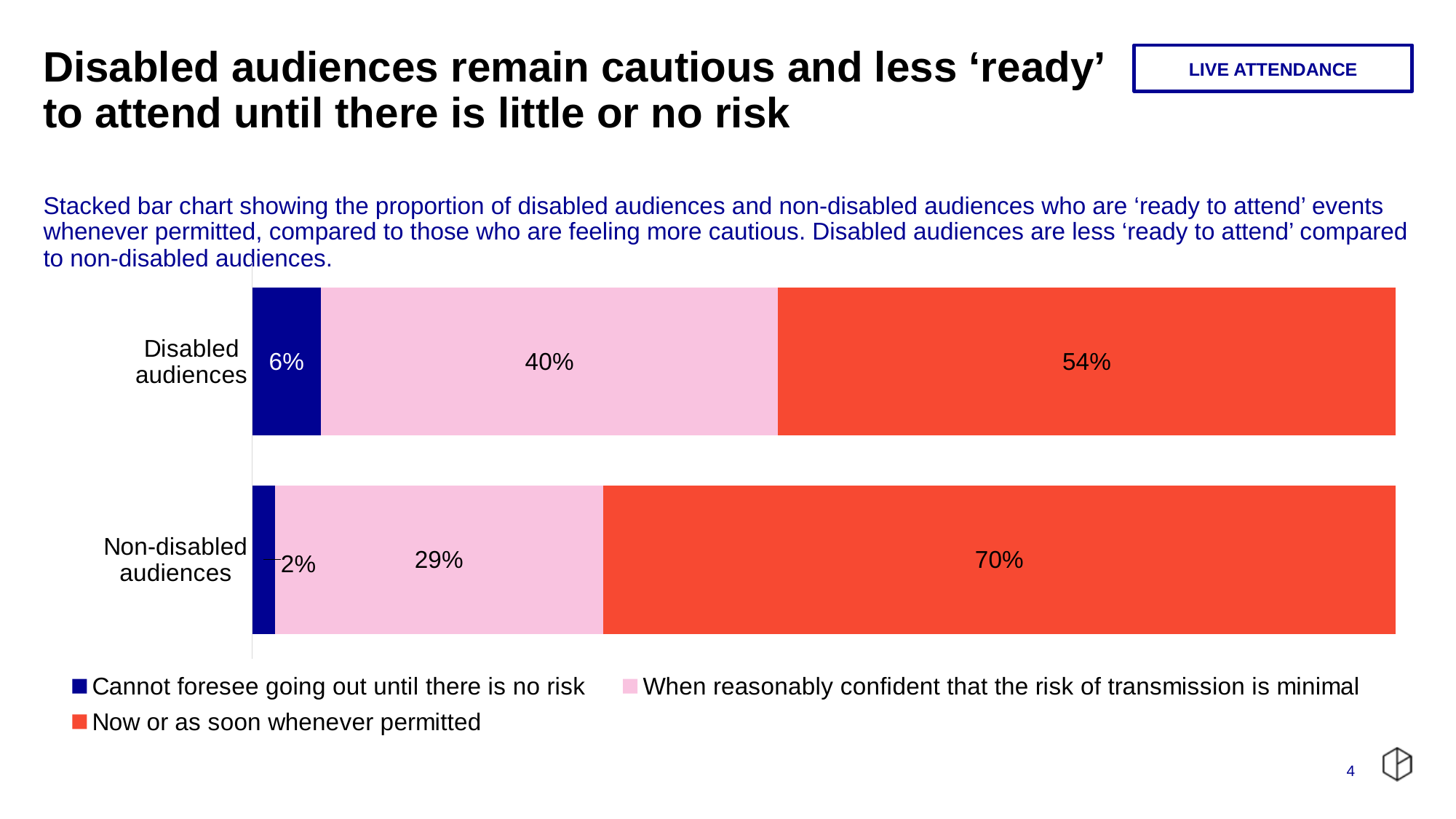
What percentage of non-disabled audiences cannot foresee going out until there is no risk? 2% How many series does the legend list? 3 What is the difference between the 'Now or as soon whenever permitted' shares for non-disabled and disabled audiences? 16 percentage points Which audience group has the higher share saying 'Now or as soon whenever permitted'? Non-disabled audiences Which colour represents 'Now or as soon whenever permitted' in the chart? Red What percentage of non-disabled audiences say they are ready to attend now or as soon as permitted? 70% How many audience groups are shown in the chart? 2 What percentage of disabled audiences say they are ready to attend now or as soon as permitted? 54% What is the total of the three segments in the Disabled audiences bar? 100% What is the difference between the 'Cannot foresee going out until there is no risk' shares for disabled and non-disabled audiences? 4 percentage points What percentage of disabled audiences would attend when reasonably confident that the risk of transmission is minimal? 40% What type of chart is shown on the slide? Stacked bar chart